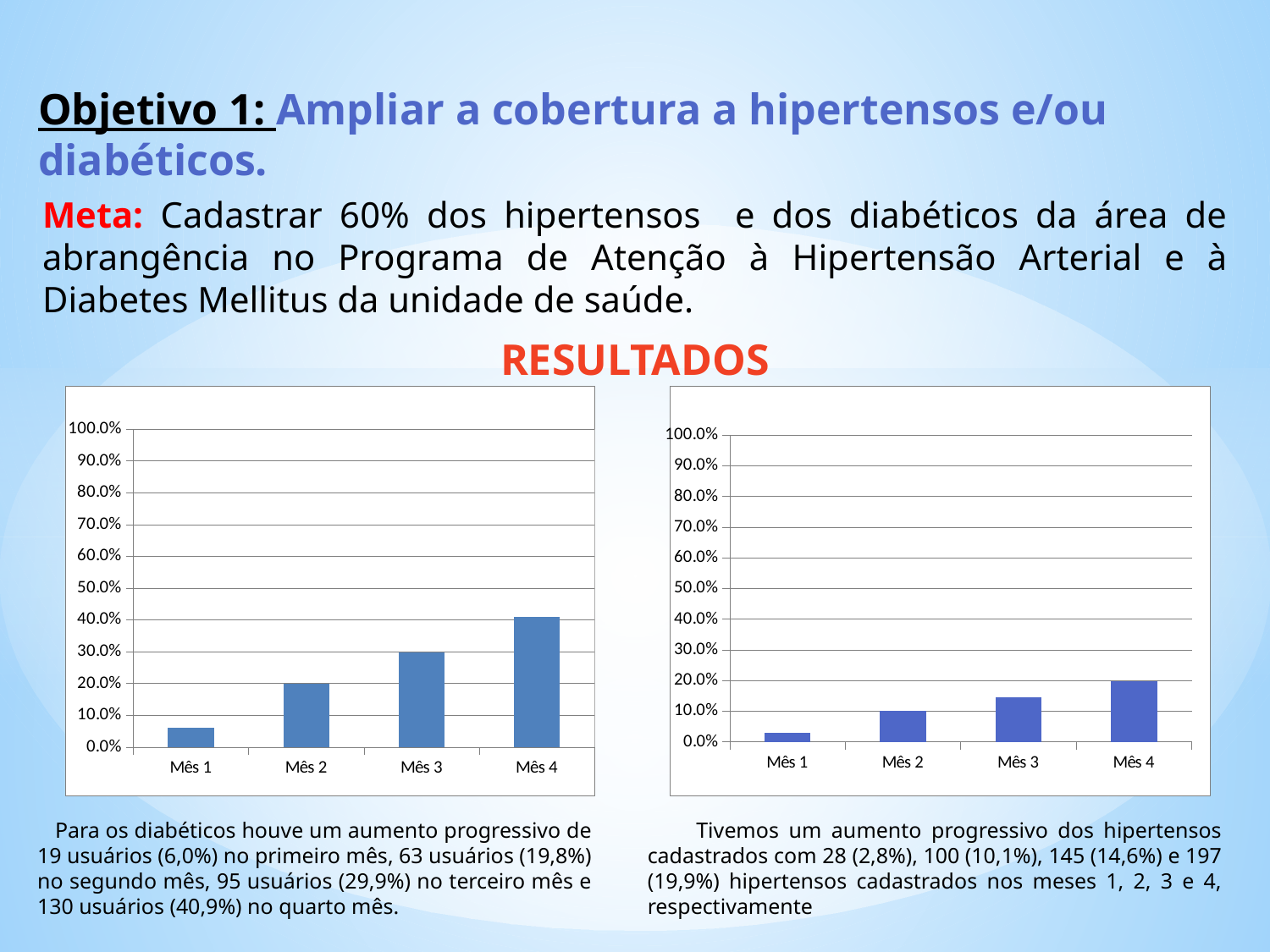
How many categories are shown on the x axis of the left chart? 4 In the right chart, is the value for Mês 4 greater or less than 30.0%? less What is the highest tick label on the y axis of the right chart? 100.0% In the left chart, which month has the highest value? Mês 4 In the left chart, is the value for Mês 4 greater or less than 30.0%? greater What kind of chart is the left chart on the slide? bar chart In the right chart, which is larger, the value for Mês 2 or the value for Mês 3? Mês 3 In the left chart, do the values rise or fall from Mês 1 to Mês 4? rise In the right chart, which month has the lowest value? Mês 1 In the left chart, which month has the lowest value? Mês 1 In the left chart, is the value for Mês 1 greater or less than 10.0%? less In the right chart, which month has the highest value? Mês 4